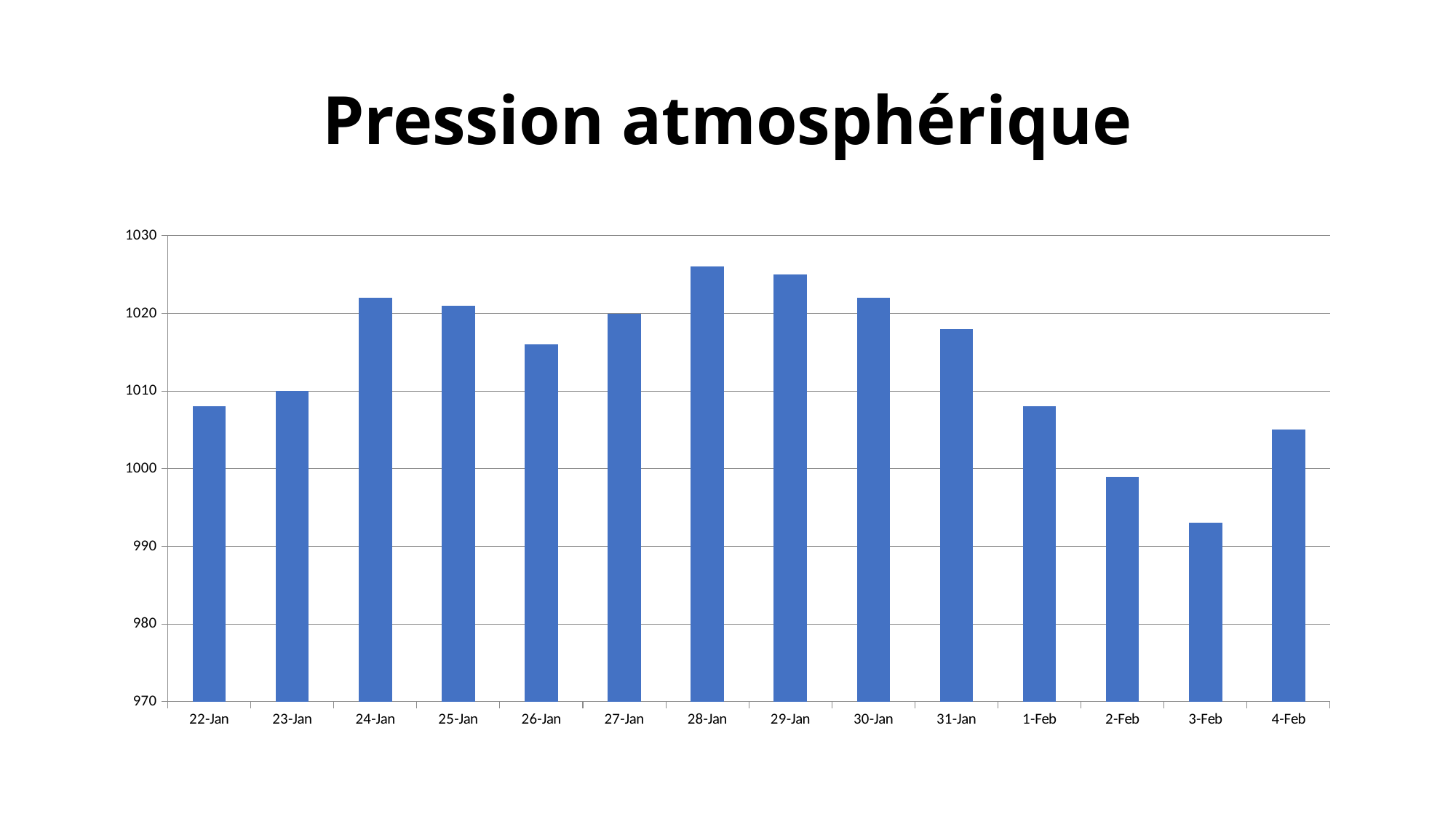
Do the values rise or fall from 31-Jan to 3-Feb? fall Which is larger, the value for 24-Jan or the value for 26-Jan? 24-Jan Is the value for 28-Jan greater or less than 1020? greater Is the value for 26-Jan greater or less than 1020? less What is the value for 27-Jan? 1020 Is the value for 3-Feb greater or less than 1000? less What is the value for 23-Jan? 1010 Which date has the highest value? 28-Jan How many dates are plotted on the x axis? 14 Which date has the lowest value? 3-Feb What kind of chart is shown on the slide? bar chart What is the title of the chart? Pression atmosphérique